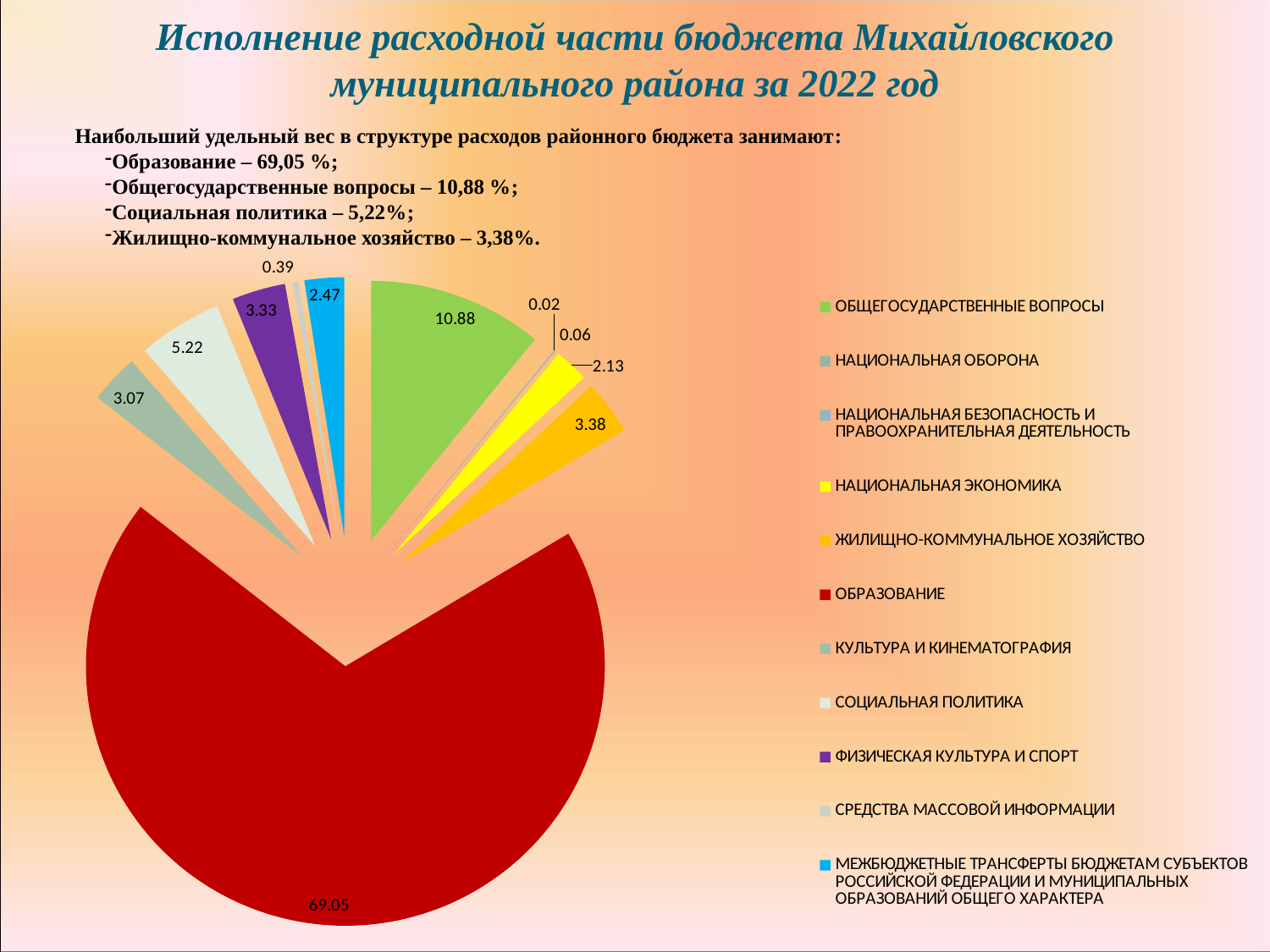
What is the value shown for ОБРАЗОВАНИЕ in the pie chart? 69.05 What is the value shown for ЖИЛИЩНО-КОММУНАЛЬНОЕ ХОЗЯЙСТВО in the pie chart? 3.38 What is the difference between the values for ОБРАЗОВАНИЕ and ОБЩЕГОСУДАРСТВЕННЫЕ ВОПРОСЫ in the pie chart? 58.17 Which is larger in the pie chart: СОЦИАЛЬНАЯ ПОЛИТИКА or КУЛЬТУРА И КИНЕМАТОГРАФИЯ? СОЦИАЛЬНАЯ ПОЛИТИКА What is the value shown for ОБЩЕГОСУДАРСТВЕННЫЕ ВОПРОСЫ in the pie chart? 10.88 Which category has the smallest slice in the pie chart? НАЦИОНАЛЬНАЯ ОБОРОНА What colour is the slice for ОБРАЗОВАНИЕ in the pie chart? red What is the value shown for СОЦИАЛЬНАЯ ПОЛИТИКА in the pie chart? 5.22 What is the value shown for ФИЗИЧЕСКАЯ КУЛЬТУРА И СПОРТ in the pie chart? 3.33 What type of chart is shown on the slide? pie chart Which category has the largest slice in the pie chart? ОБРАЗОВАНИЕ How many categories does the legend of the pie chart list? 11